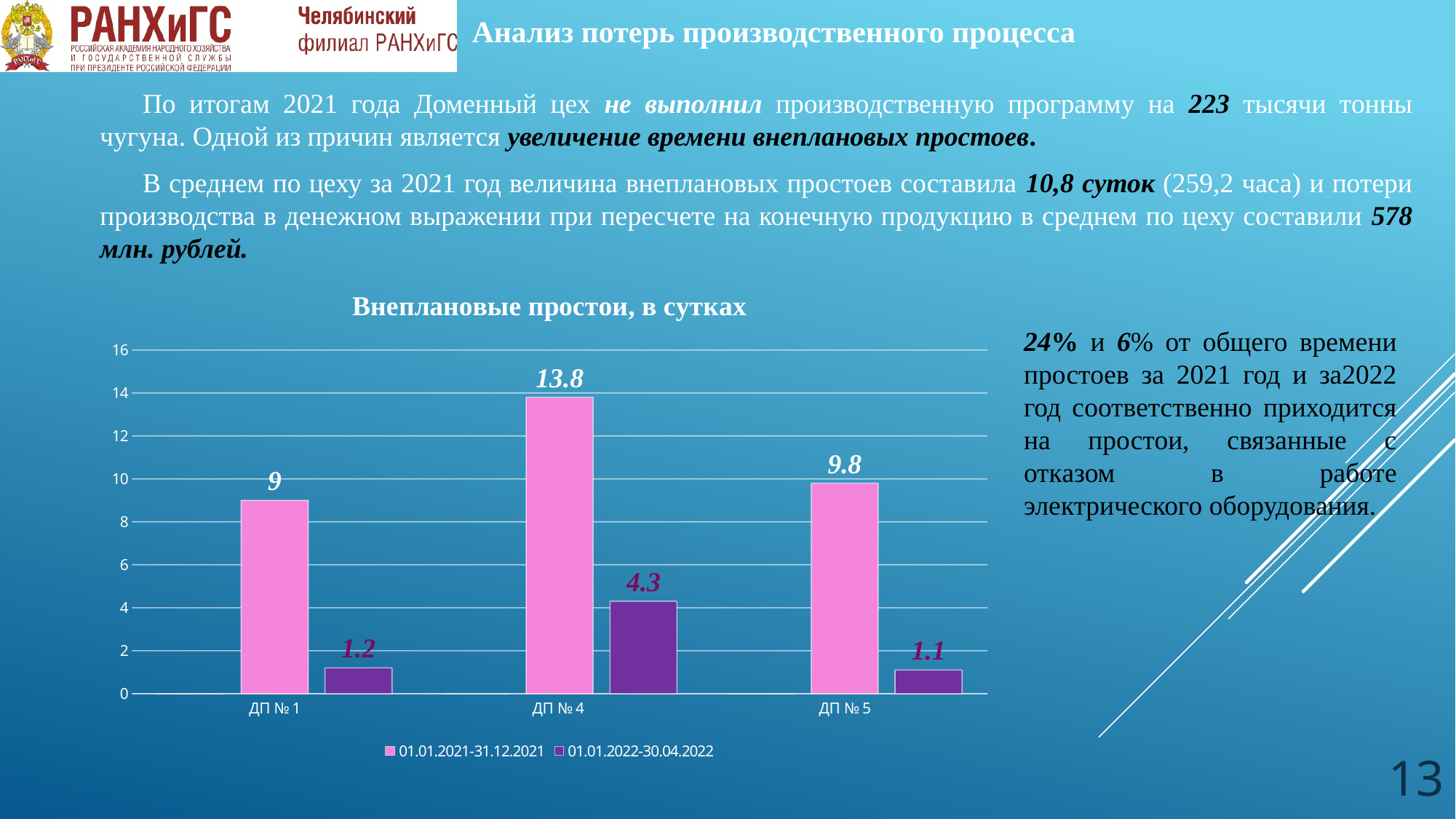
What type of chart is shown on the slide? bar chart How many categories are shown on the x axis of the chart? 3 What is the difference between the 01.01.2021-31.12.2021 and 01.01.2022-30.04.2022 values for ДП № 4? 9.5 What is the value for ДП № 4 in the 01.01.2021-31.12.2021 series? 13.8 Which category has the highest value in the 01.01.2021-31.12.2021 series? ДП № 4 Which category has the lowest value in the 01.01.2022-30.04.2022 series? ДП № 5 Is the 01.01.2021-31.12.2021 value for ДП № 4 greater or less than 12? greater Which is larger: the 01.01.2021-31.12.2021 value for ДП № 1 or for ДП № 5? ДП № 5 How many series does the chart legend list? 2 What is the value for ДП № 5 in the 01.01.2021-31.12.2021 series? 9.8 What is the value for ДП № 1 in the 01.01.2022-30.04.2022 series? 1.2 What is the title of the chart? Внеплановые простои, в сутках